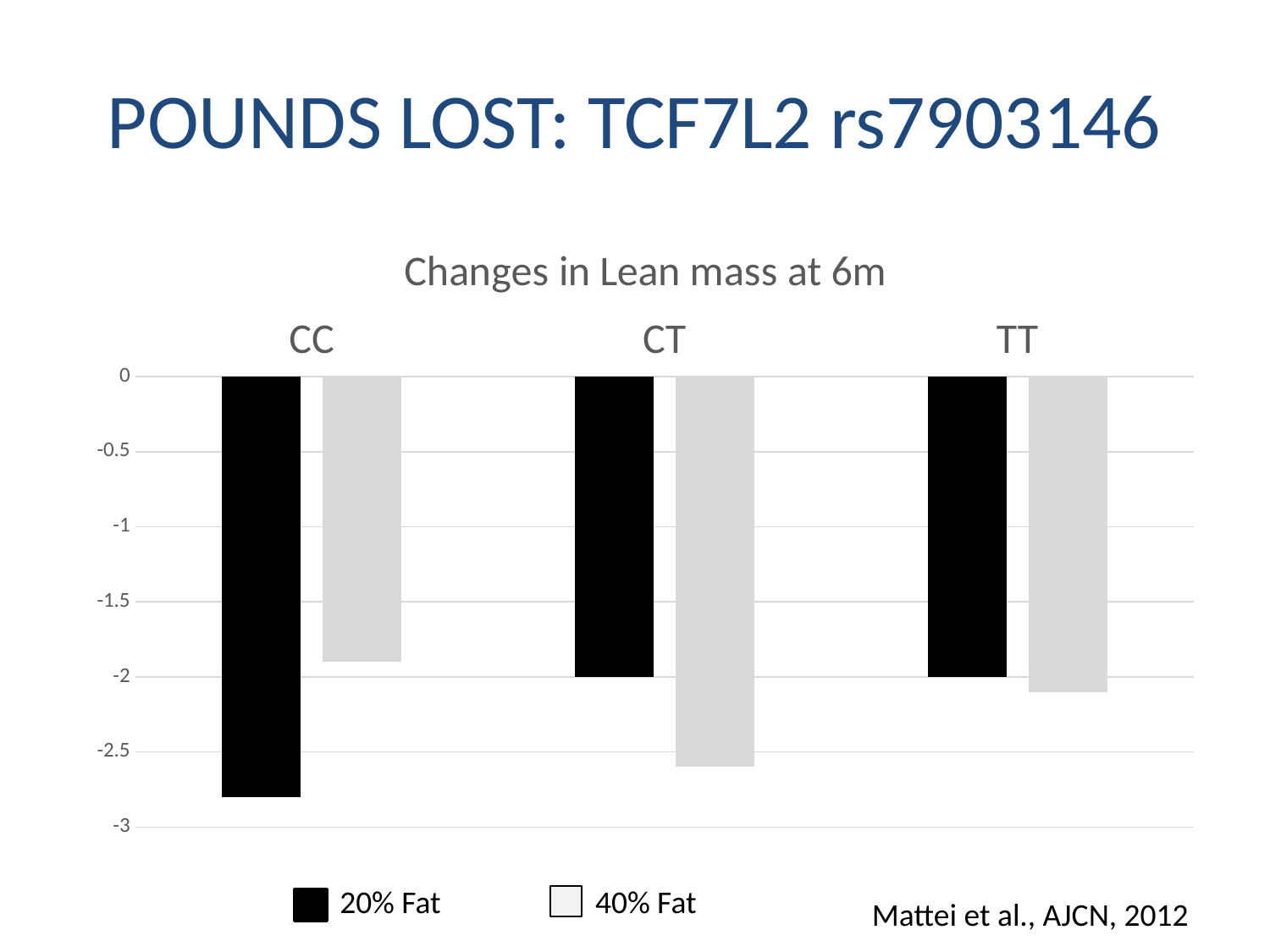
How many genotype categories are shown on the x axis? 3 What kind of chart is shown on the slide? bar chart How many series does the legend list? 2 Is the value for 40% Fat in the CT category greater or less than -2.5? less Which category has the most negative value for the 40% Fat series? CT Is the value for 20% Fat in the CC category greater or less than -2.5? less Which category has the most negative value for the 20% Fat series? CC Which colour represents the 40% Fat series? light gray What is the value for 20% Fat in the CT category? -2 In the CC category, which series has the more negative value, 20% Fat or 40% Fat? 20% Fat What is the title of the chart? Changes in Lean mass at 6m Is the value for 40% Fat in the CC category greater or less than -2? greater